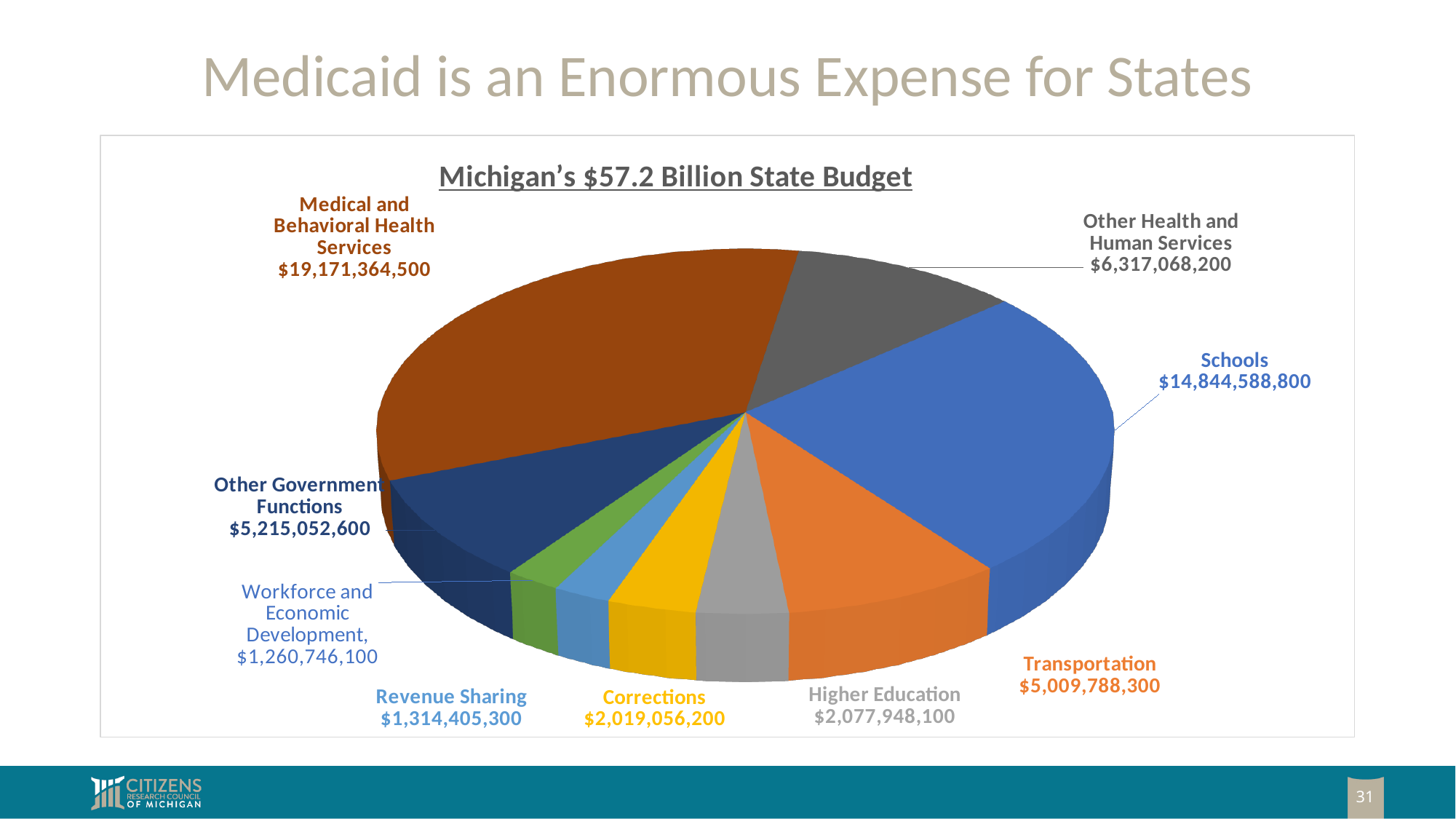
What is the value for Schools in the pie chart? $14,844,588,800 Which category has the largest slice of the pie chart? Medical and Behavioral Health Services What is the title of the chart? Michigan's $57.2 Billion State Budget How many categories are shown in the pie chart? 9 What is the difference between Medical and Behavioral Health Services and Schools? $4,326,775,700 What is the difference between Higher Education and Corrections? $58,891,900 What is the value for Other Health and Human Services? $6,317,068,200 Which category has the smallest value in the pie chart? Workforce and Economic Development What is the value for Corrections in the pie chart? $2,019,056,200 Which is larger, Other Government Functions or Transportation? Other Government Functions Which is larger, Revenue Sharing or Workforce and Economic Development? Revenue Sharing What type of chart is shown on the slide? Pie chart